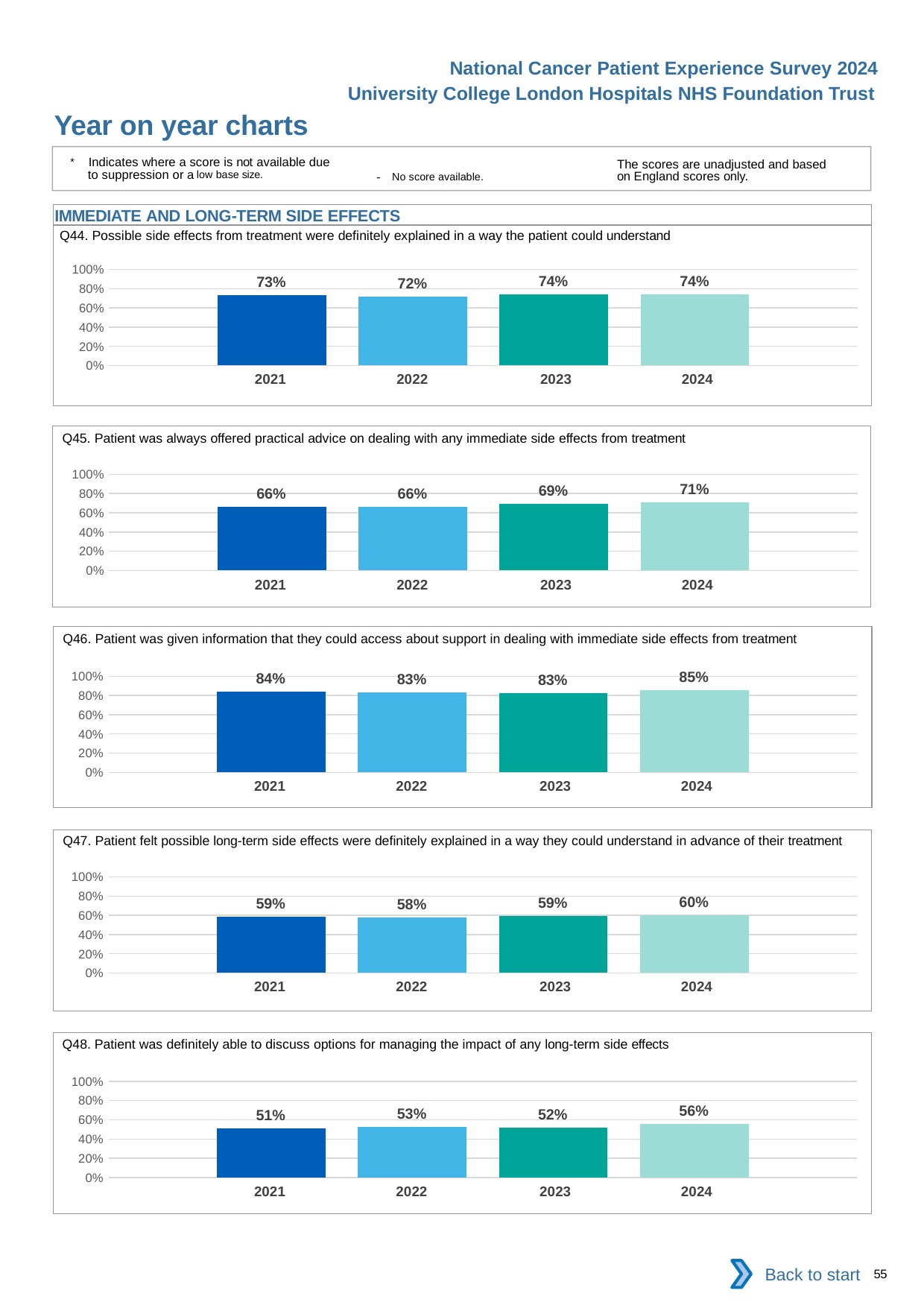
In the Q47 chart, is the value for 2024 greater or less than 80%? less In the Q45 chart, which year has the highest value? 2024 In the Q48 chart, which is larger, the value for 2022 or the value for 2023? 2022 In the Q46 chart, which year has the lowest value? 2022 and 2023 What is the section heading above the Q44 chart? IMMEDIATE AND LONG-TERM SIDE EFFECTS In the Q45 chart, what is the difference between the 2024 and 2021 values? 5% In the Q47 chart, which year has the lowest value? 2022 In the Q46 chart, what is the value for 2024? 85% What type of chart is used for Q45? Bar chart In the Q48 chart, what is the difference between the 2024 and 2021 values? 5% How many bars are in the Q44 chart? 4 In the Q44 chart, what is the value for 2021? 73%